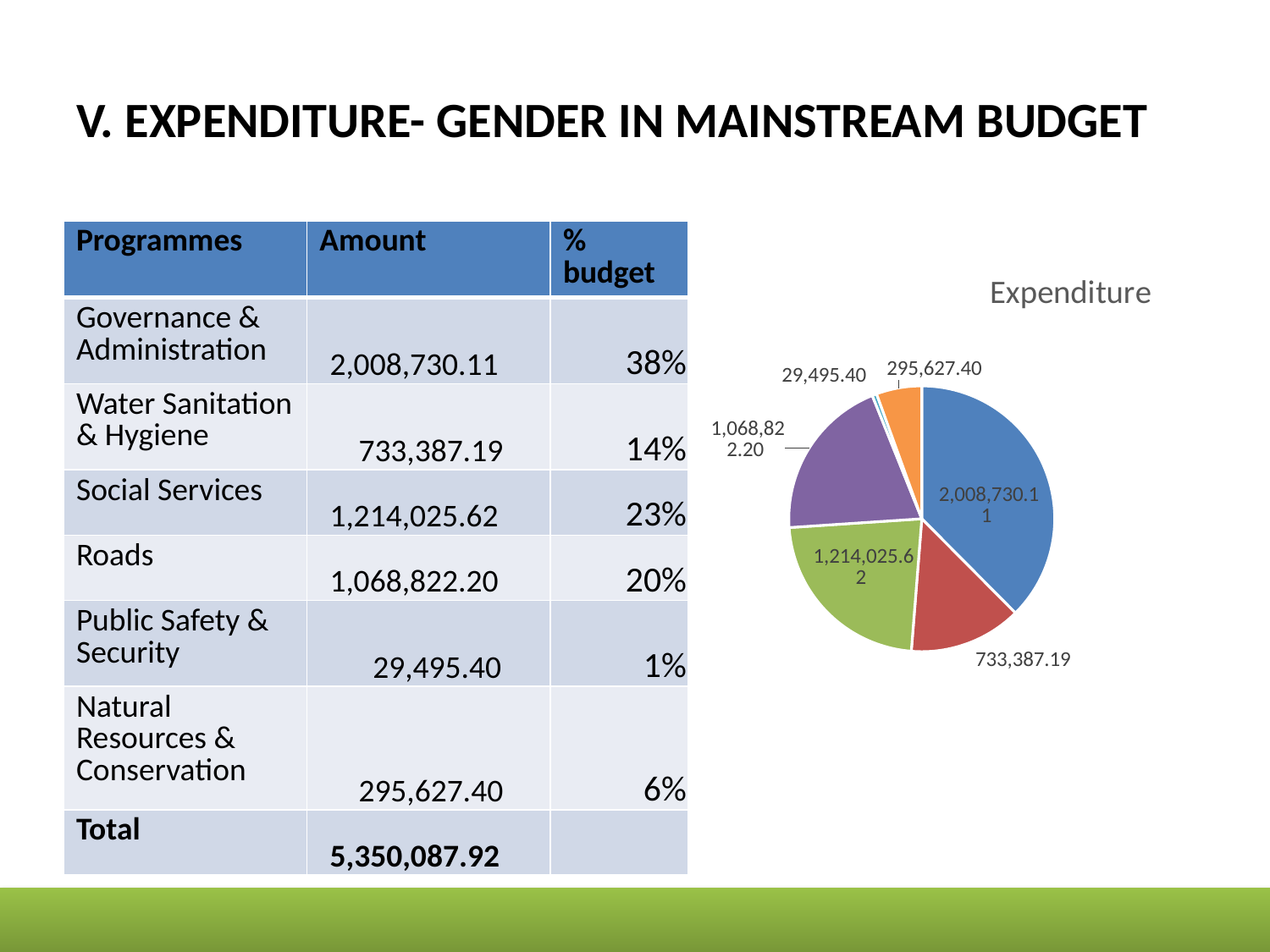
In the Expenditure pie chart, what value is shown on the red slice? 733,387.19 In the Expenditure pie chart, what value is shown on the orange slice? 295,627.40 In the Expenditure pie chart, what value is shown on the green slice? 1,214,025.62 What is the title of the chart? Expenditure What share of the Expenditure pie does the largest slice (2,008,730.11, Governance & Administration) represent, according to the slide? 38% What is the difference between the slice labelled 2,008,730.11 and the slice labelled 733,387.19 in the Expenditure pie chart? 1,275,342.92 How many slices does the Expenditure pie chart have? 6 In the Expenditure pie chart, which slice is larger: the one labelled 1,214,025.62 or the one labelled 1,068,822.20? 1,214,025.62 What is the value of the largest slice in the Expenditure pie chart? 2,008,730.11 What is the value of the smallest slice in the Expenditure pie chart? 29,495.40 What type of chart is shown on the slide? pie chart In the Expenditure pie chart, what value is shown on the purple slice? 1,068,822.20